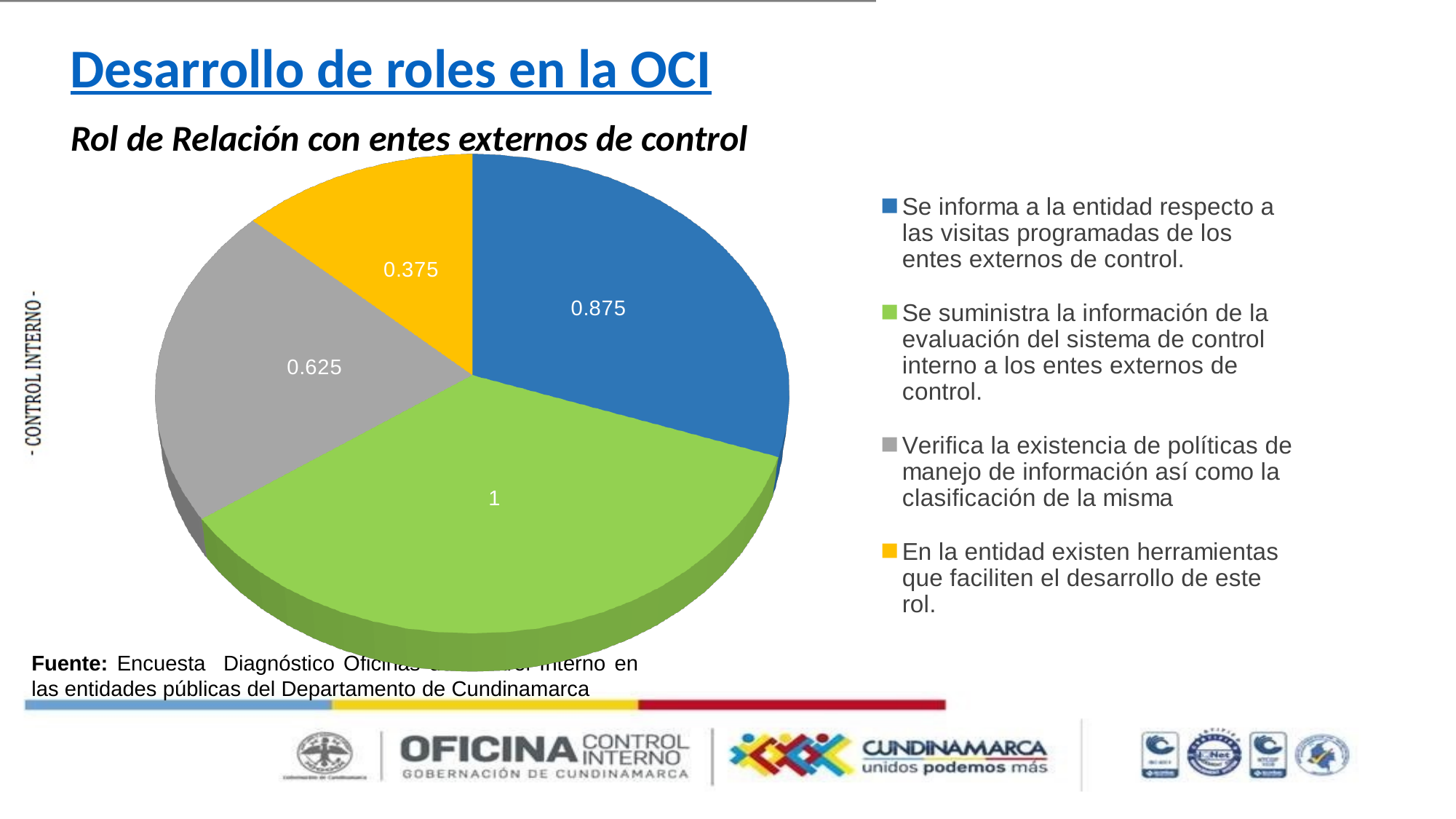
Which is larger: the value for 'Verifica la existencia de políticas de manejo de información' or the value for 'Se informa a la entidad respecto a las visitas programadas'? Se informa a la entidad respecto a las visitas programadas de los entes externos de control. What value is shown for the slice 'Se informa a la entidad respecto a las visitas programadas de los entes externos de control'? 0.875 What colour is the slice labelled 0.625? Gray How many entries does the legend list? 4 Which legend category has the smallest slice in the pie chart? En la entidad existen herramientas que faciliten el desarrollo de este rol. What value is shown for the slice 'Se suministra la información de la evaluación del sistema de control interno a los entes externos de control'? 1 What value is shown for the slice 'Verifica la existencia de políticas de manejo de información así como la clasificación de la misma'? 0.625 Which legend category has the largest slice in the pie chart? Se suministra la información de la evaluación del sistema de control interno a los entes externos de control. What is the difference between the value of the blue slice (0.875) and the yellow slice (0.375)? 0.5 What kind of chart is shown on the slide? Pie chart How many slices does the pie chart have? 4 What value is shown for the slice 'En la entidad existen herramientas que faciliten el desarrollo de este rol'? 0.375